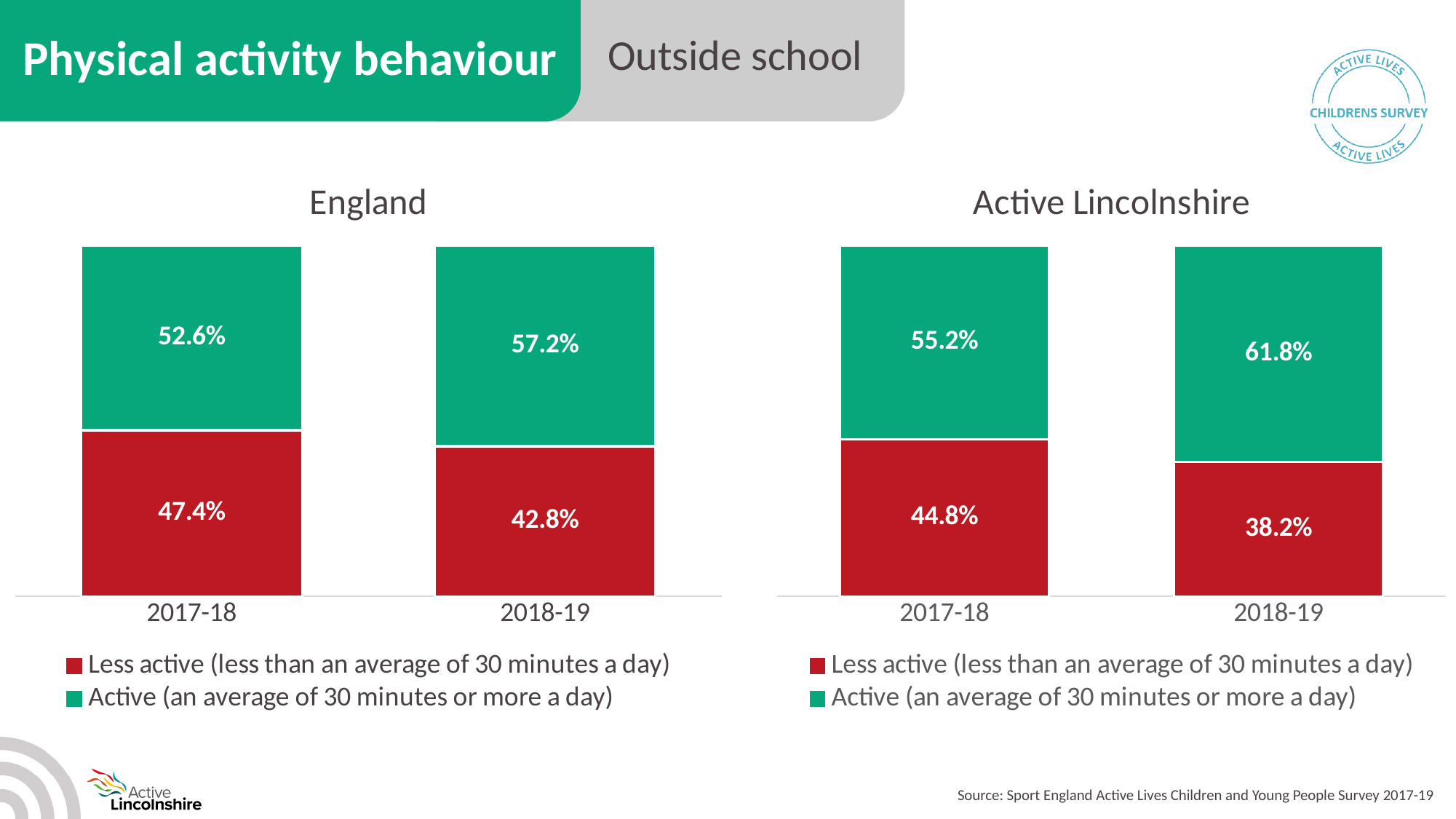
In the England chart, what is the value for Active (an average of 30 minutes or more a day) in 2018-19? 57.2% How many series does the legend of the England chart list? 2 In the Active Lincolnshire chart, what is the total of the stacked bar for 2018-19? 100% In the Active Lincolnshire chart, what is the value for Less active (less than an average of 30 minutes a day) in 2017-18? 44.8% In the England chart, which year has the lower Less active value? 2018-19 In the Active Lincolnshire chart, what is the value for Active (an average of 30 minutes or more a day) in 2018-19? 61.8% In the England chart, what is the difference between the Active values for 2018-19 and 2017-18? 4.6% In the Active Lincolnshire chart, what is the difference between the Less active values for 2017-18 and 2018-19? 6.6% In the England chart, what is the value for Less active (less than an average of 30 minutes a day) in 2017-18? 47.4% In the Active Lincolnshire chart, which year has the higher Active value, 2017-18 or 2018-19? 2018-19 What type of chart is the Active Lincolnshire chart? Stacked bar chart In the England chart, does the Active share rise or fall from 2017-18 to 2018-19? rise